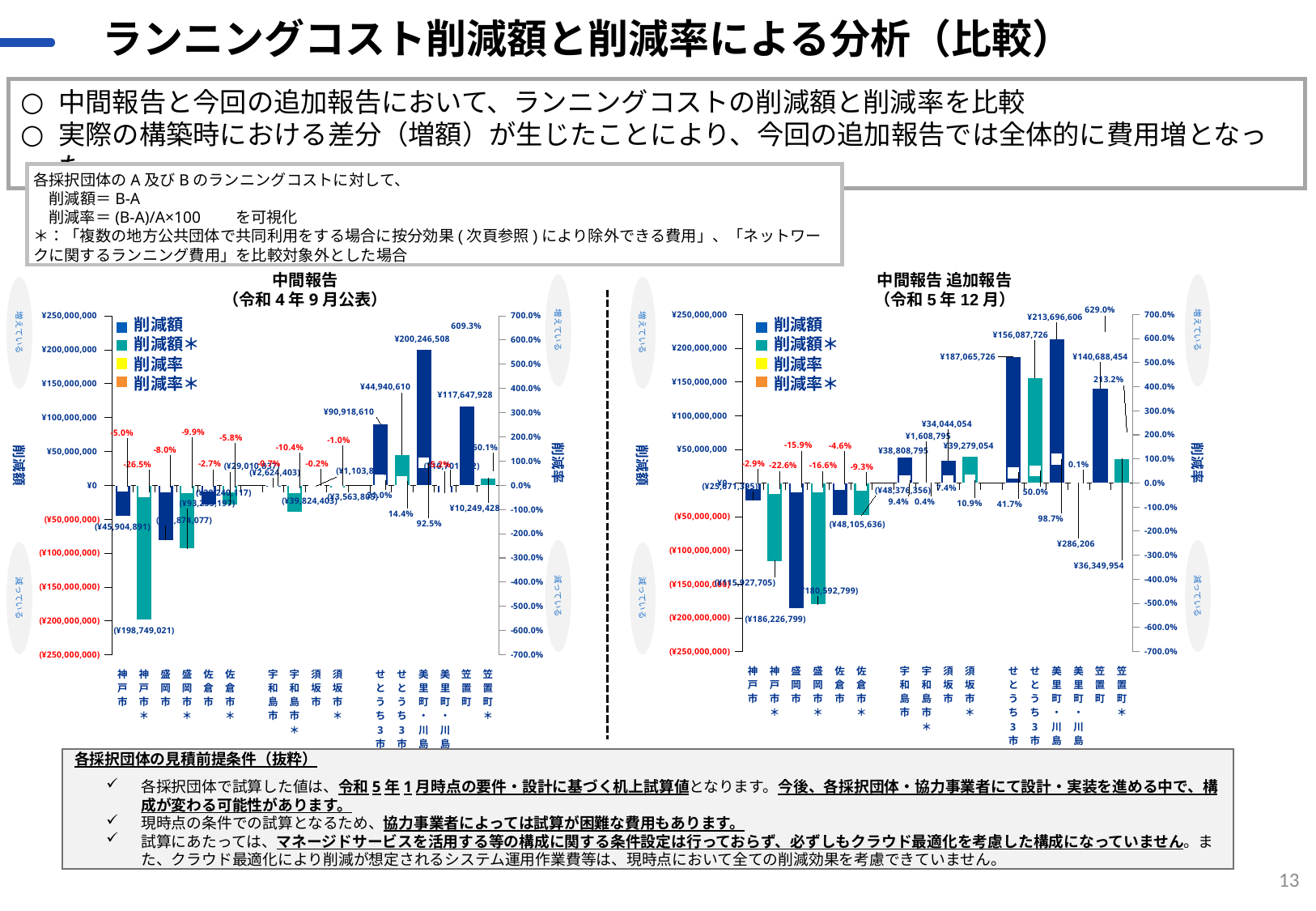
In the 中間報告 追加報告（令和5年12月） chart, what is the 削減額 value for 美里町・川島? ¥213,696,606 What kind of chart is the 中間報告（令和4年9月公表） chart on the left? bar chart In the 中間報告 追加報告（令和5年12月） chart, which has the larger 削減額 bar, せとうち3市 or 笠置町? せとうち3市 How many categories are shown on the x axis of the 中間報告（令和4年9月公表） chart? 16 In the 中間報告 追加報告（令和5年12月） chart, what is the 削減額 value for 笠置町? ¥140,688,454 In the 中間報告 追加報告（令和5年12月） chart, what is the highest 削減率 value labelled? 629.0% In the 中間報告（令和4年9月公表） chart, what is the 削減額 value for 美里町・川島? ¥200,246,508 How many series does the legend of the 中間報告 追加報告（令和5年12月） chart list? 4 In the 中間報告 追加報告（令和5年12月） chart, what is the difference between the 削減額 of 美里町・川島 and 笠置町? ¥73,008,152 In the 中間報告（令和4年9月公表） chart, which category has the lowest (most negative) 削減額 bar? 神戸市＊ In the 中間報告（令和4年9月公表） chart, what is the 削減額＊ value for 神戸市＊? (¥198,749,021) In the 中間報告（令和4年9月公表） chart, which category has the highest 削減額? 美里町・川島